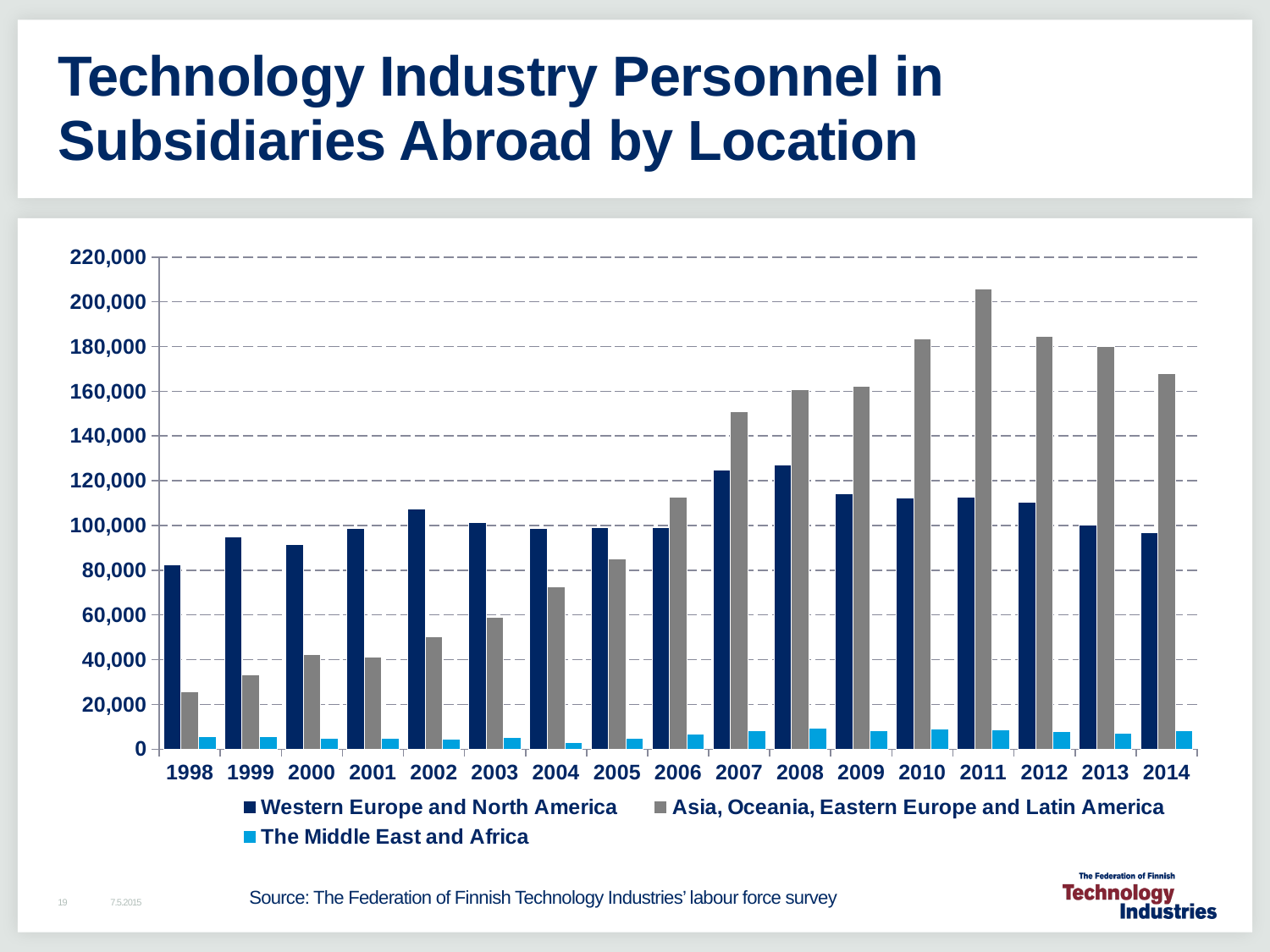
In which year is the value for Asia, Oceania, Eastern Europe and Latin America highest? 2011 In 2005, which is larger: Western Europe and North America or Asia, Oceania, Eastern Europe and Latin America? Western Europe and North America In which year is the value for Asia, Oceania, Eastern Europe and Latin America lowest? 1998 How many series does the legend list? 3 Is the value for Asia, Oceania, Eastern Europe and Latin America in 2011 greater or less than 200,000? greater Is the value for Asia, Oceania, Eastern Europe and Latin America in 1998 greater or less than 40,000? less In 2014, which is larger: Western Europe and North America or Asia, Oceania, Eastern Europe and Latin America? Asia, Oceania, Eastern Europe and Latin America In which year is the value for Western Europe and North America lowest? 1998 How many years are shown on the x axis? 17 Is the value for Western Europe and North America in 2002 greater or less than 100,000? greater What kind of chart is shown on the slide? Bar chart Which series is shown in light blue in the legend? The Middle East and Africa